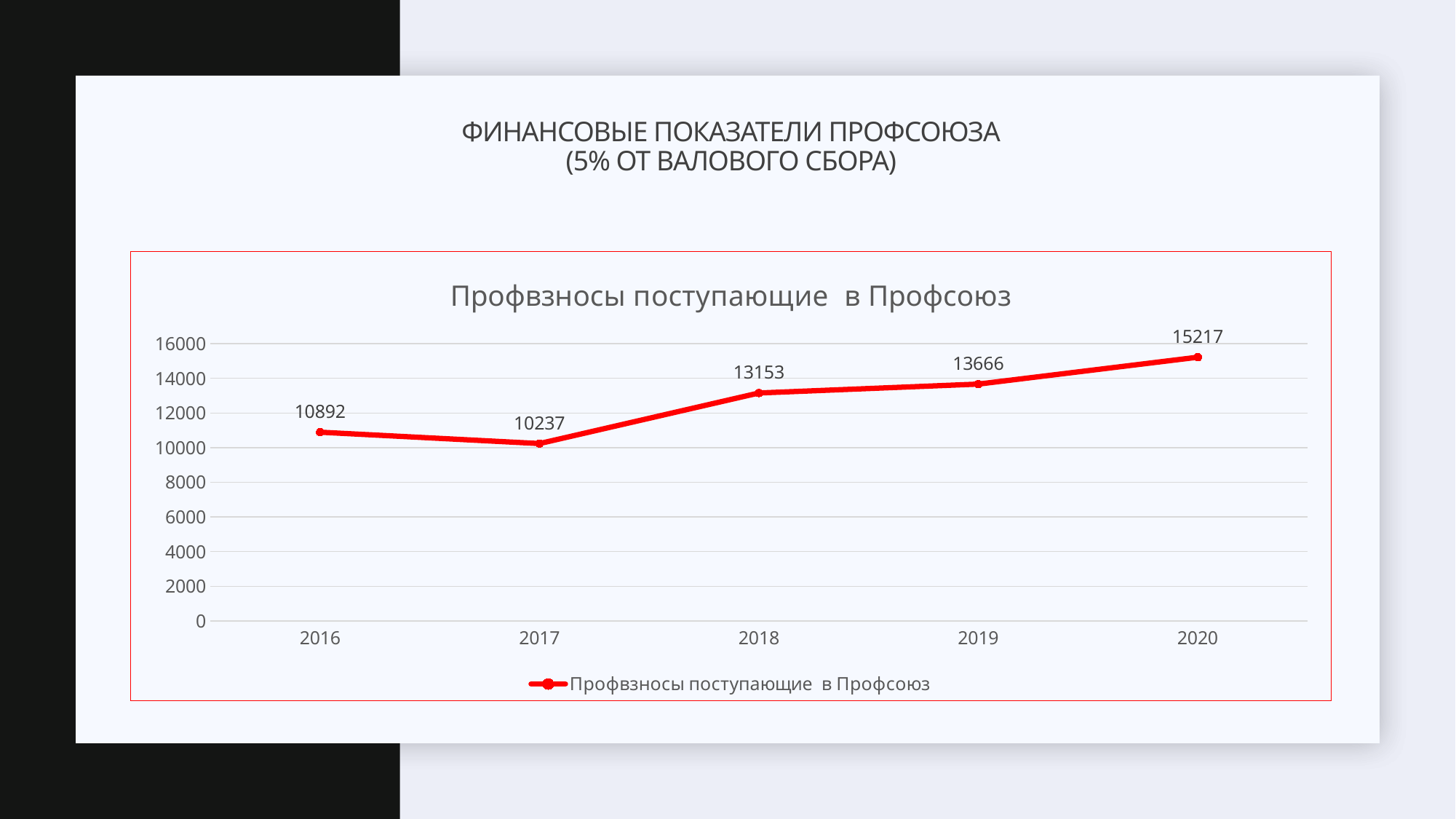
Which year has the lowest value? 2017 What kind of chart is shown? line chart Which is larger, the value for 2016 or the value for 2017? 2016 How many years are plotted on the x axis? 5 What is the value for 2018? 13153 Is the value for 2019 greater or less than 12000? greater What is the value for 2017? 10237 Which year has the highest value? 2020 What is the title of the chart? Профвзносы поступающие в Профсоюз What is the value for 2020? 15217 What is the value for 2016? 10892 What is the difference between the values for 2020 and 2019? 1551